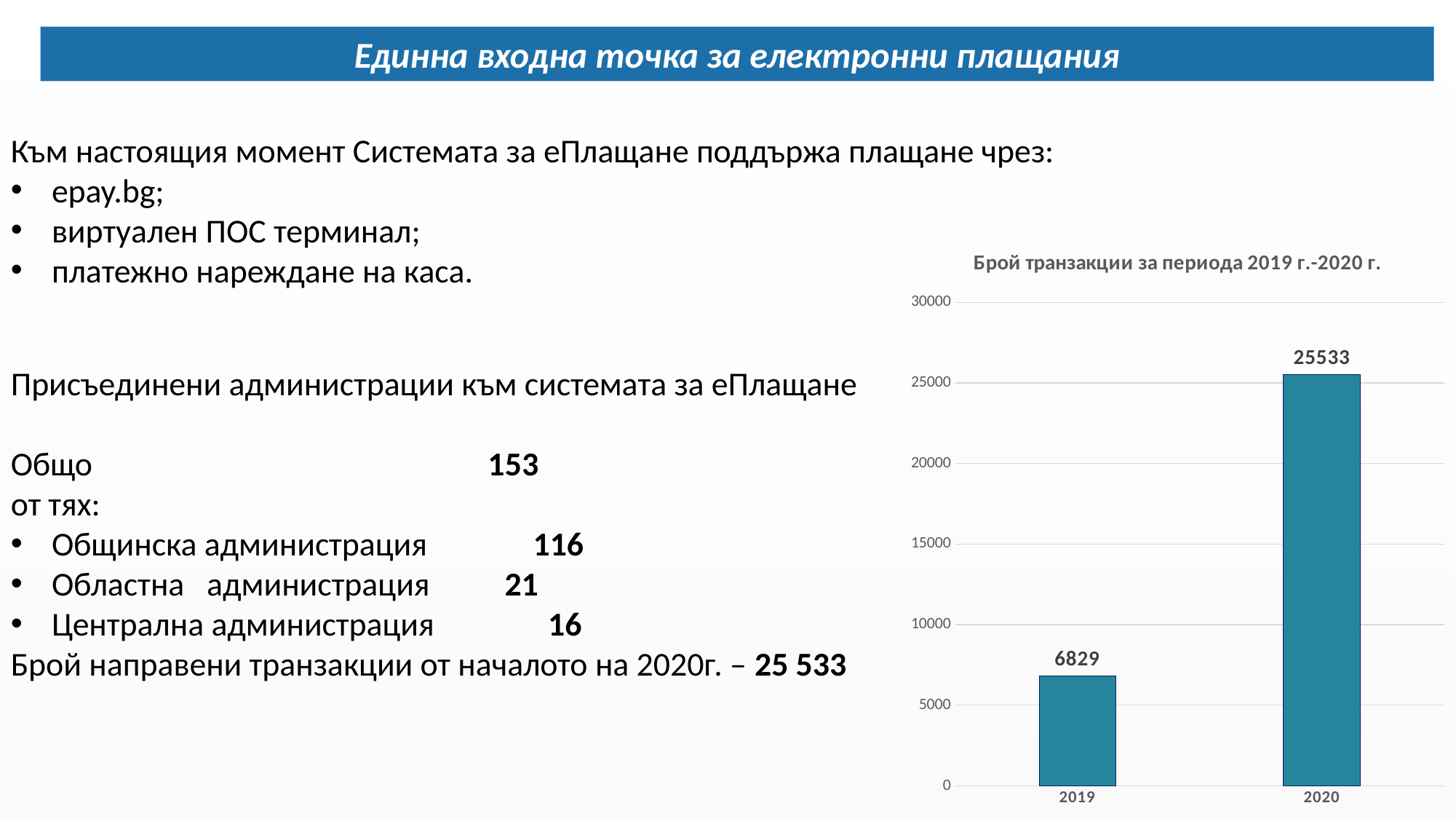
What is the value for 2019 in the chart? 6829 What is the difference between the 2020 and 2019 values in the chart? 18704 Which year has the highest number of transactions in the chart? 2020 What is the title of the chart? Брой транзакции за периода 2019 г.-2020 г. Is the value for 2020 greater or less than 25000? greater What is the value for 2020 in the chart? 25533 Do the values rise or fall from 2019 to 2020 in the chart? rise What kind of chart is shown on the slide? bar chart Is the value for 2019 greater or less than 10000? less How many categories are shown on the x axis of the chart? 2 Which is larger in the chart, the value for 2019 or the value for 2020? 2020 Which year has the lowest number of transactions in the chart? 2019